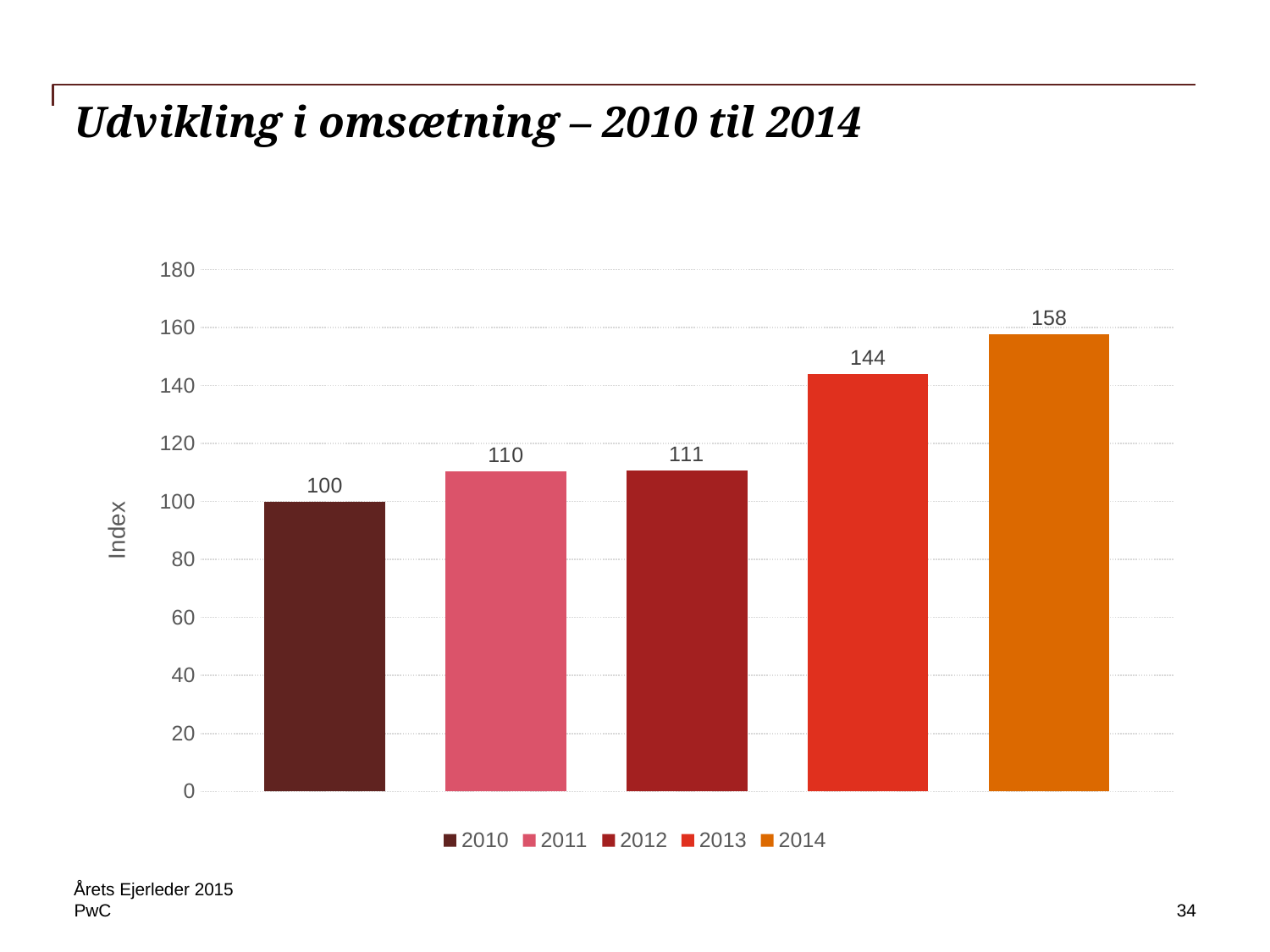
What is the index value for 2013? 144 What kind of chart is shown on the slide? Bar chart How many bars are shown in the chart? 5 Which year has the highest index value? 2014 What is the index value for 2010? 100 Which year has the lowest index value? 2010 Do the index values generally rise or fall from 2010 to 2014? Rise What is the index value for 2014? 158 What is the difference between the index values for 2014 and 2010? 58 How many entries does the legend list? 5 What is the difference between the index values for 2013 and 2012? 33 Which is larger, the index value for 2013 or for 2011? 2013